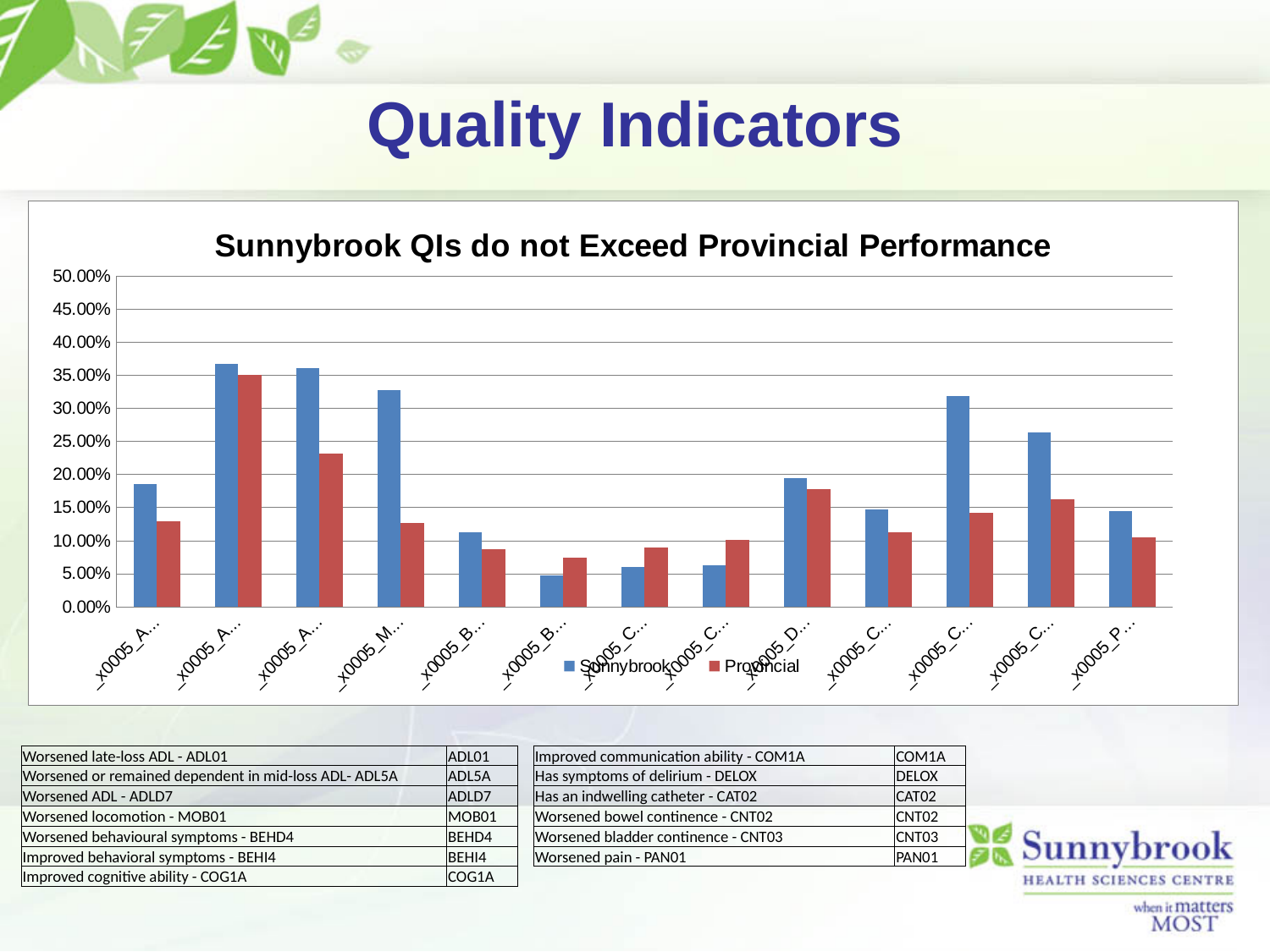
For the leftmost category on the chart, which series has the larger value, Sunnybrook or Provincial? Sunnybrook What are the two series named in the chart legend? Sunnybrook and Provincial What is the highest value shown on the chart's y axis? 50.00% For the second category from the left on the chart, is the Sunnybrook value greater or less than 30.00%? greater What kind of chart is shown on the slide? bar chart For the rightmost category on the chart, is the Provincial value greater or less than 15.00%? less How many series does the chart legend list? 2 What is the title of the chart? Sunnybrook QIs do not Exceed Provincial Performance How many categories are plotted along the x axis of the chart? 13 For the leftmost category on the chart, is the Sunnybrook value greater or less than 15.00%? greater For the sixth category from the left on the chart, which series has the larger value, Sunnybrook or Provincial? Provincial